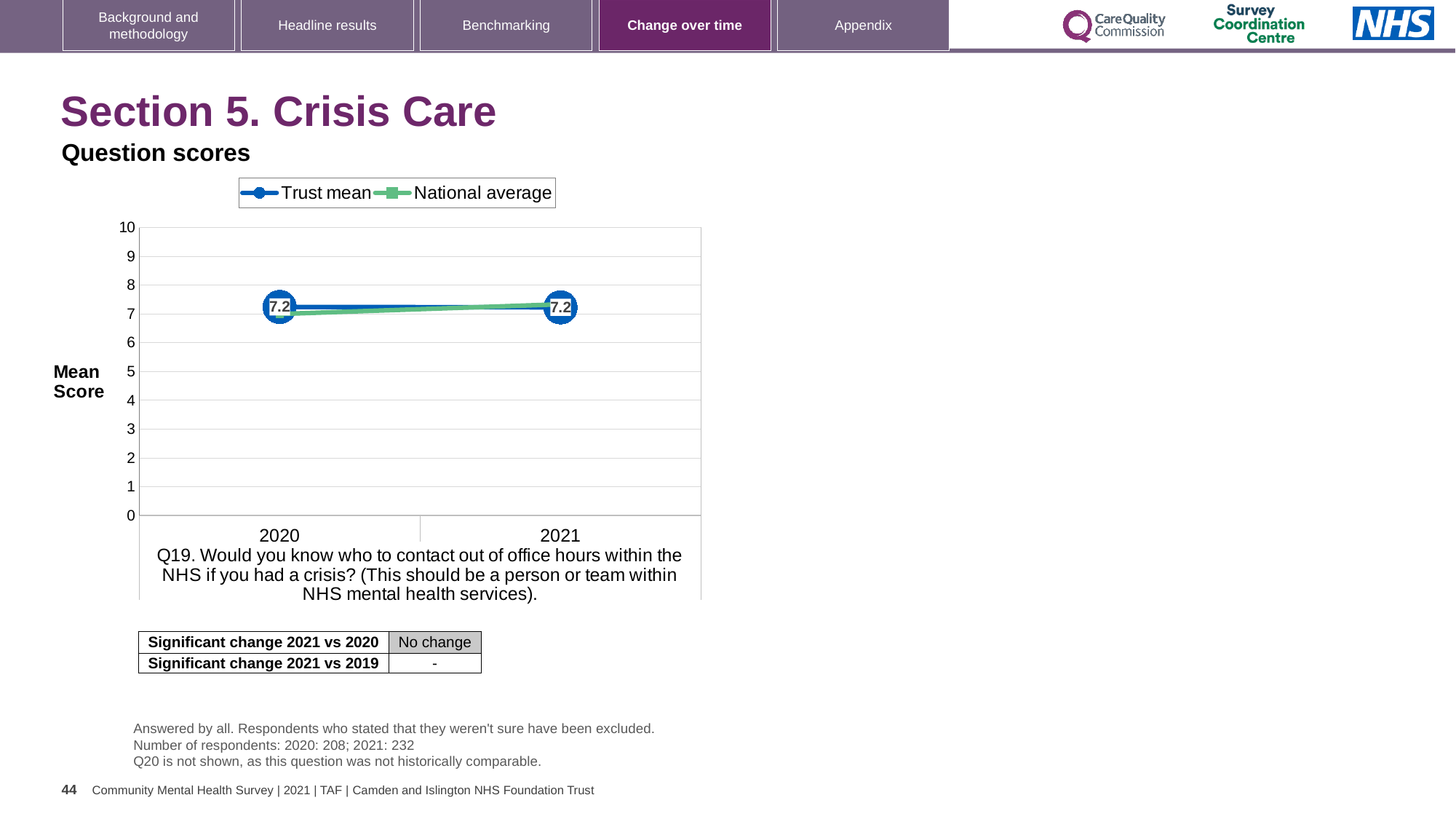
What is the Trust mean score for 2020? 7.2 What is the label on the y axis of the chart? Mean Score Does the Trust mean score rise, fall or stay the same from 2020 to 2021? Stays the same What kind of chart is shown on the slide? Line chart What is the Trust mean score for 2021? 7.2 Is the National average value for 2020 greater or less than 8? less How many series does the chart legend list? 2 Is the National average value for 2021 greater or less than 5? greater How many years are plotted on the x axis of the chart? 2 Which two series are listed in the chart legend? Trust mean and National average What is the difference between the Trust mean score in 2021 and in 2020? 0